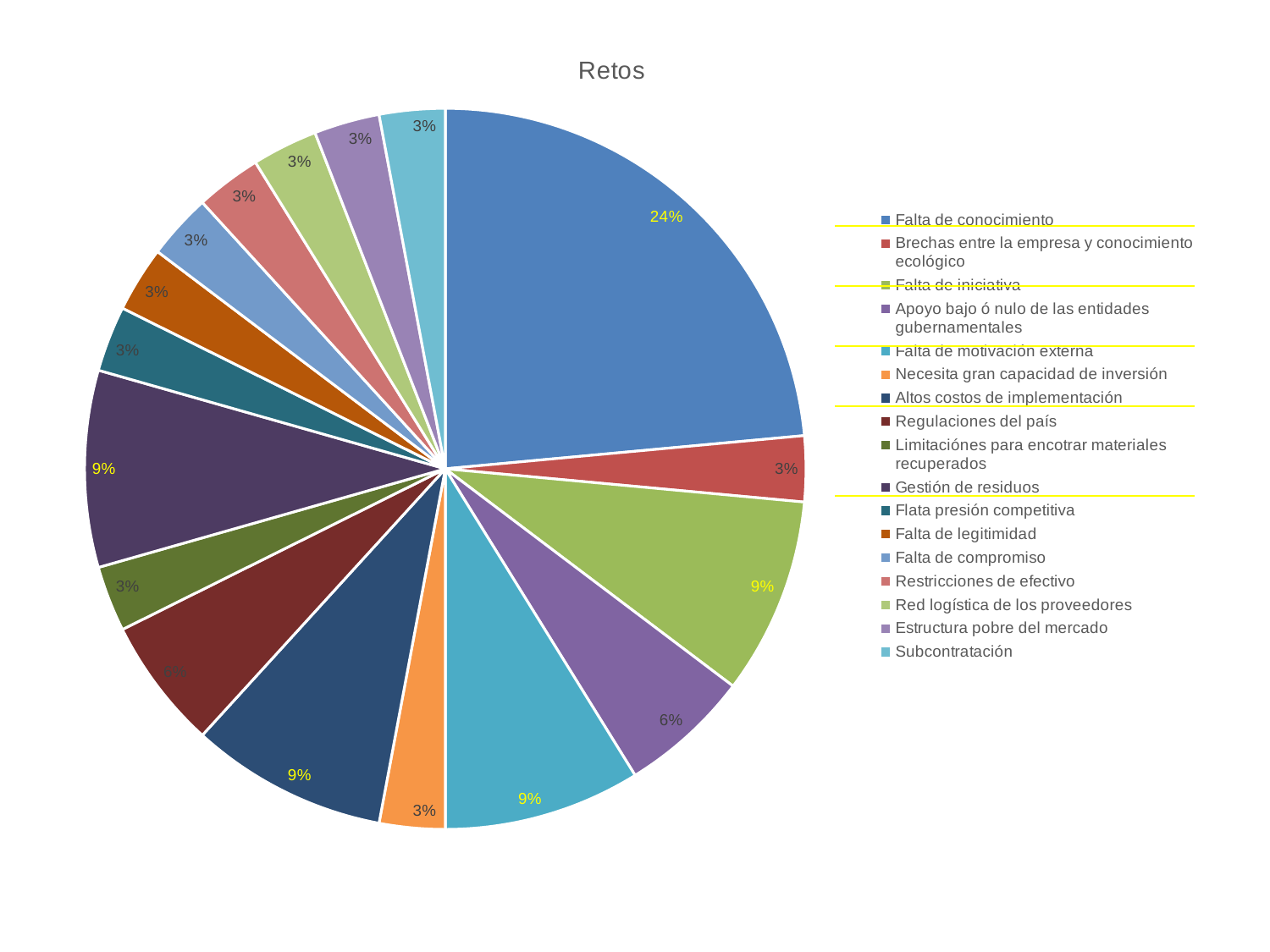
Which category has the largest slice of the pie? Falta de conocimiento What is the value shown for Falta de iniciativa? 9% What is the value shown for Brechas entre la empresa y conocimiento ecológico? 3% What share of the pie does Falta de conocimiento represent? 24% What is the value shown for Altos costos de implementación? 9% What is the difference between the shares of Falta de conocimiento and Gestión de residuos? 15% What is the value shown for Necesita gran capacidad de inversión? 3% Which is larger, the slice for Falta de motivación externa or the slice for Subcontratación? Falta de motivación externa How many categories does the legend list? 17 What is the title of the chart? Retos What is the value shown for Apoyo bajo ó nulo de las entidades gubernamentales? 6% What type of chart is shown on the slide? pie chart